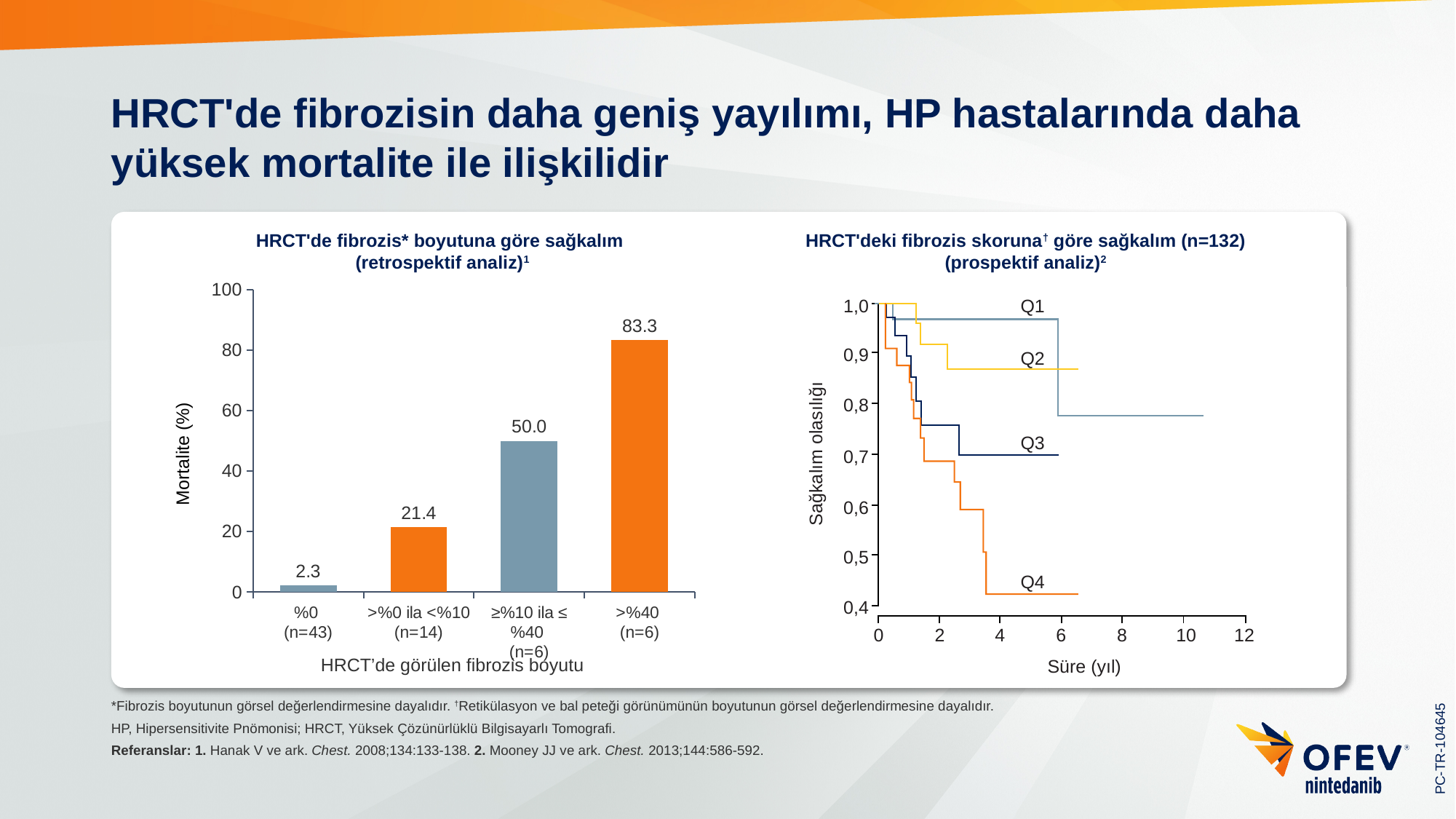
In the left chart (HRCT'de fibrozis boyutuna göre sağkalım), which category has the highest mortality? >%40 (n=6) In the right chart (HRCT'deki fibrozis skoruna göre sağkalım), how many quartile curves (Q1–Q4) are plotted? 4 In the right chart (HRCT'deki fibrozis skoruna göre sağkalım), which curve ends with the lowest survival probability? Q4 What kind of chart is the left chart (HRCT'de fibrozis boyutuna göre sağkalım)? bar chart In the left chart (HRCT'de fibrozis boyutuna göre sağkalım), which category has the lowest mortality? %0 (n=43) In the left chart (HRCT'de fibrozis boyutuna göre sağkalım), what is the mortality (%) for the %0 (n=43) category? 2.3 In the left chart (HRCT'de fibrozis boyutuna göre sağkalım), what is the mortality (%) for the >%40 (n=6) category? 83.3 In the left chart (HRCT'de fibrozis boyutuna göre sağkalım), what is the mortality (%) for the >%0 ila <%10 (n=14) category? 21.4 In the left chart (HRCT'de fibrozis boyutuna göre sağkalım), how many fibrosis extent categories are shown? 4 In the left chart (HRCT'de fibrozis boyutuna göre sağkalım), does mortality rise or fall as fibrosis extent increases along the x axis? rise In the right chart (HRCT'deki fibrozis skoruna göre sağkalım), is the final survival probability for Q4 greater or less than 0,5? less In the left chart (HRCT'de fibrozis boyutuna göre sağkalım), what is the difference in mortality (%) between the >%40 and the ≥%10 ila ≤%40 categories? 33.3